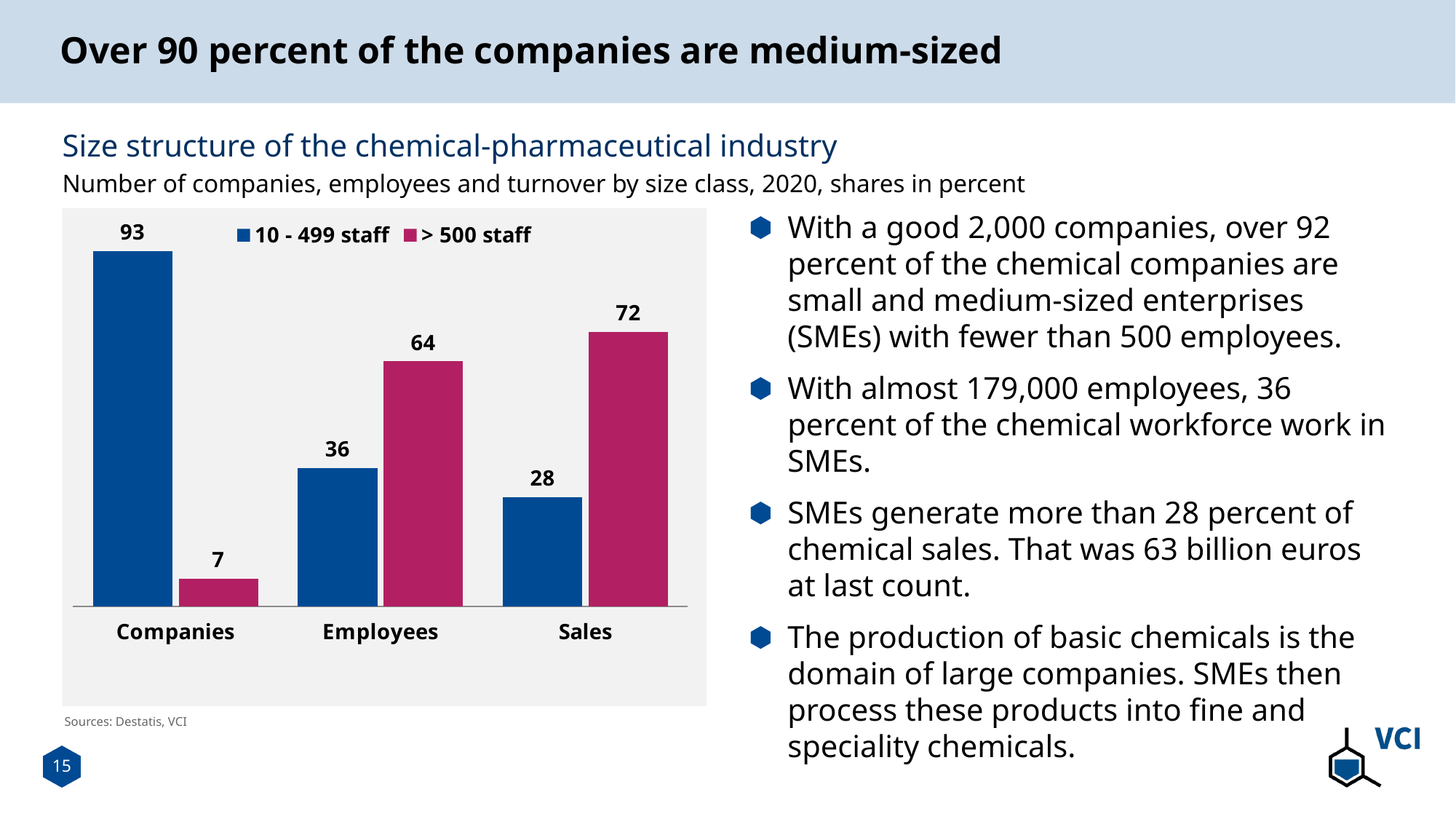
What is the value for Companies in the 10 - 499 staff series? 93 What is the value for Sales in the 10 - 499 staff series? 28 Which category has the lowest value in the 10 - 499 staff series? Sales What is the total of the 10 - 499 staff and > 500 staff values for Sales? 100 Which category has the highest value in the > 500 staff series? Sales What is the difference between the 10 - 499 staff and > 500 staff values for Companies? 86 What is the value for Companies in the > 500 staff series? 7 What is the value for Employees in the > 500 staff series? 64 For Employees, which series has the larger value: 10 - 499 staff or > 500 staff? > 500 staff How many categories are shown on the x axis? 3 How many series does the legend list? 2 What kind of chart is shown on the slide? Bar chart